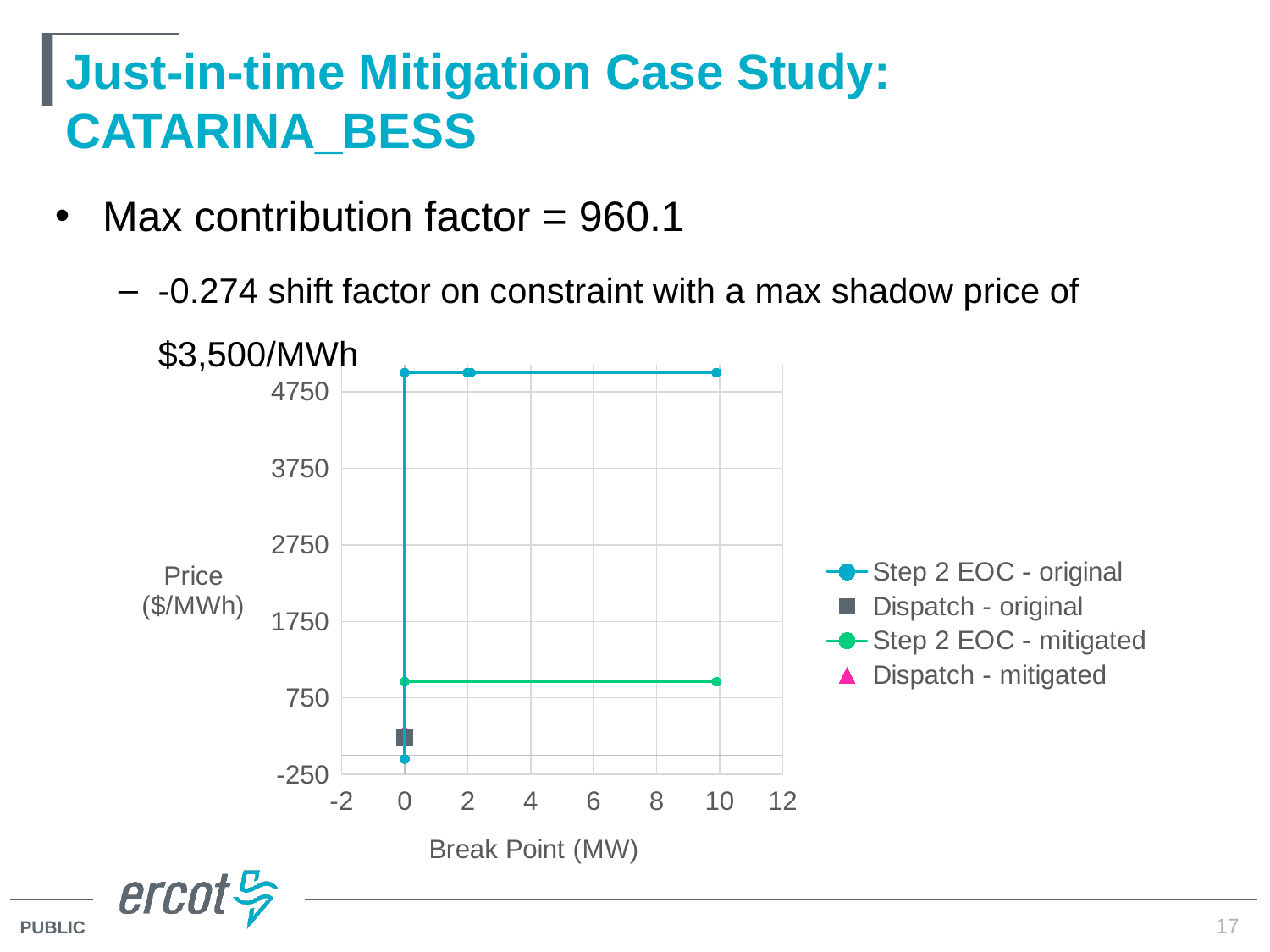
Which series has the higher price at a break point of 2 MW, Step 2 EOC - original or Step 2 EOC - mitigated? Step 2 EOC - original What kind of chart is shown on the slide? line chart How many series does the chart legend list? 4 What is the title of the y axis of the chart? Price ($/MWh) What is the highest tick value shown on the y axis of the chart? 4750 Is the price of the Dispatch - original point greater or less than 750? less Is the price of the Step 2 EOC - mitigated series at a break point of 10 MW greater or less than 750? greater Does the price of the Step 2 EOC - mitigated series rise, fall, or stay flat as the break point increases from 0 to 10 MW? stay flat Is the price of the Step 2 EOC - original series at a break point of 10 MW greater or less than 4750? greater What is the title of the x axis of the chart? Break Point (MW) Which series has the higher price at a break point of 10 MW, Step 2 EOC - original or Step 2 EOC - mitigated? Step 2 EOC - original